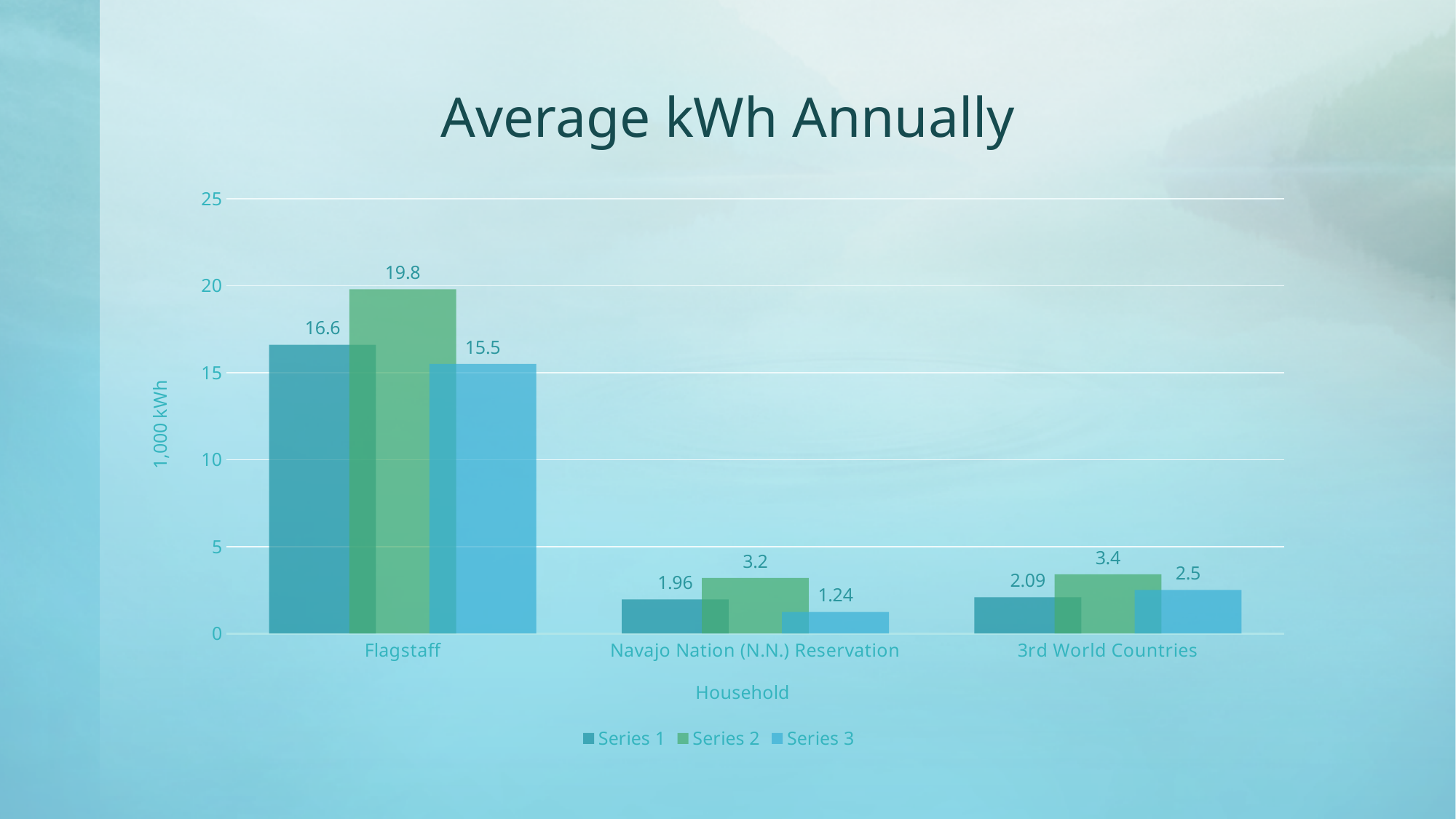
What is the difference between the Series 2 and Series 1 values for Flagstaff? 3.2 How many series does the legend list? 3 What kind of chart is shown on the slide? Bar chart What is the Series 3 value for Navajo Nation (N.N.) Reservation? 1.24 How many categories are shown on the x axis? 3 Which category has the lowest Series 3 value? Navajo Nation (N.N.) Reservation Is the Series 1 value for Flagstaff greater or less than 15? greater Which is larger for 3rd World Countries: the Series 2 value or the Series 3 value? Series 2 Which category has the highest Series 2 value? Flagstaff What is the title of the chart? Average kWh Annually What is the Series 1 value for 3rd World Countries? 2.09 What is the Series 2 value for Flagstaff? 19.8